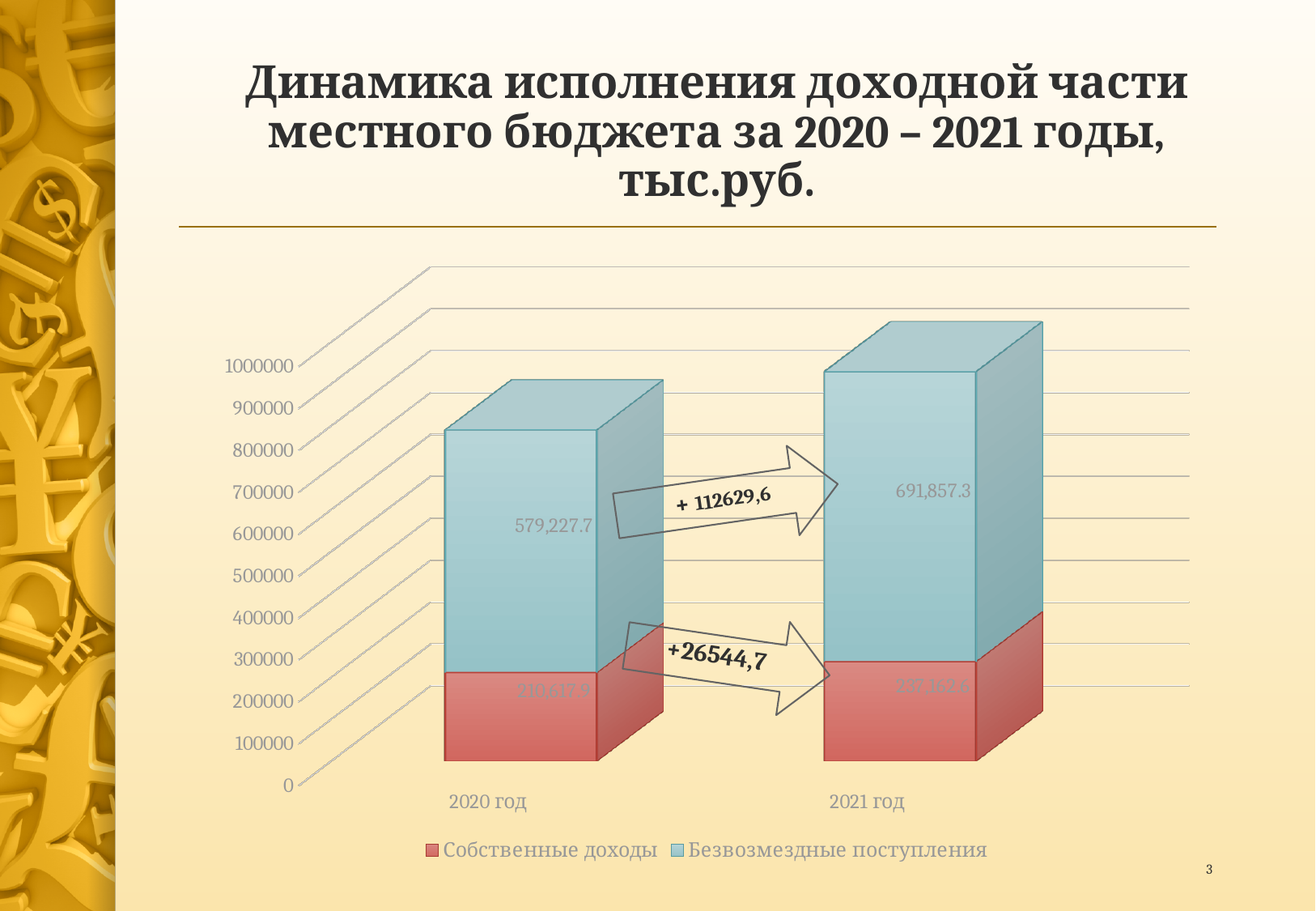
What is the total of the stacked bar for 2021 год? 929,019.9 How many categories (years) are shown on the x axis? 2 How many series does the legend list? 2 What is the value of Собственные доходы for 2020 год? 210,617.9 Which series is shown in red in the legend? Собственные доходы By how much did Безвозмездные поступления increase from 2020 год to 2021 год? 112,629.6 What type of chart is shown on the slide? Stacked bar chart By how much did Собственные доходы increase from 2020 год to 2021 год? 26,544.7 What is the value of Безвозмездные поступления for 2021 год? 691,857.3 What is the value of Безвозмездные поступления for 2020 год? 579,227.7 What is the total of the stacked bar for 2020 год? 789,845.6 What is the value of Собственные доходы for 2021 год? 237,162.6